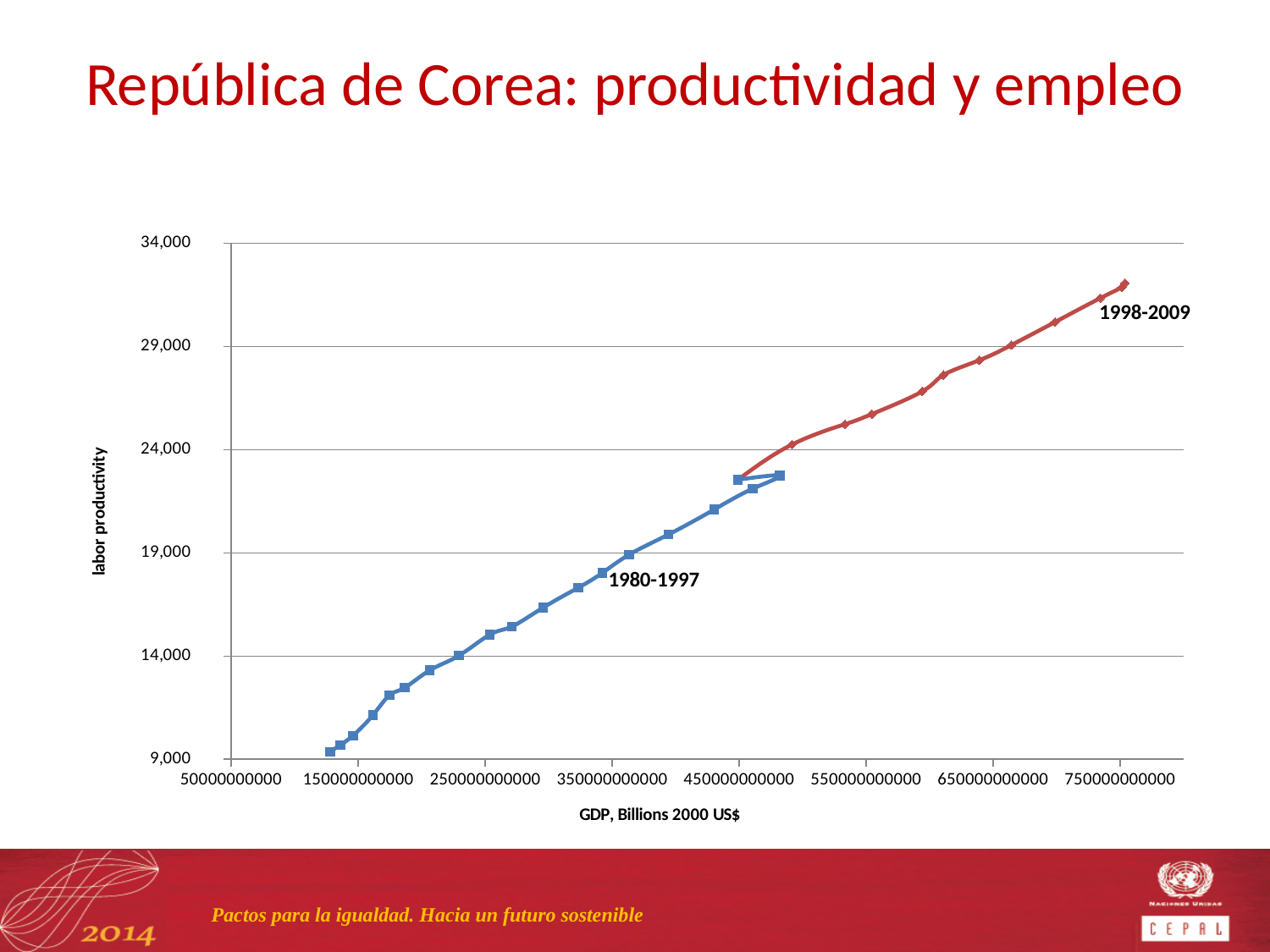
Which series contains the highest labor productivity value on the chart? 1998-2009 What type of chart is shown on the slide? line chart Is the highest labor productivity value in the 1998-2009 series greater or less than 29,000? greater What is the highest tick value shown on the vertical axis? 34,000 Is the lowest labor productivity value in the 1980-1997 series greater or less than 14,000? less How many data series are plotted on the chart? 2 Which series reaches higher labor productivity values, 1980-1997 or 1998-2009? 1998-2009 Which series has the lowest labor productivity value on the chart? 1980-1997 Does labor productivity rise or fall as GDP increases along the x axis? rise Is the first point of the 1998-2009 series greater or less than 19,000 in labor productivity? greater What is the title of the slide containing the chart? República de Corea: productividad y empleo What is the label of the vertical axis? labor productivity